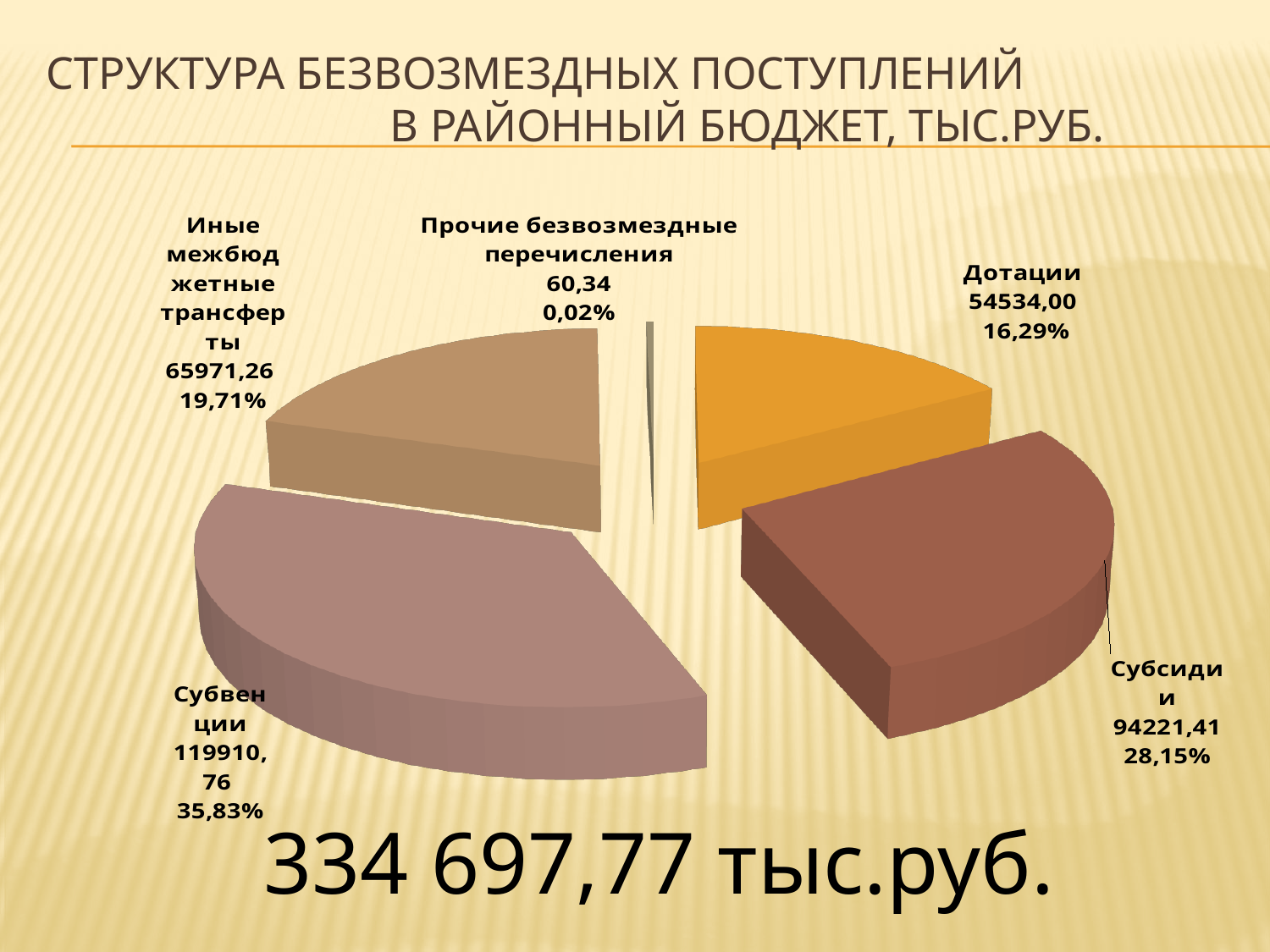
Which is larger, Дотации or Иные межбюджетные трансферты? Иные межбюджетные трансферты What share of the pie does Прочие безвозмездные перечисления represent? 0,02% What is the value for Субвенции? 119910,76 What is the difference between the values for Субвенции and Субсидии? 25689,35 What share of the pie does Субсидии represent? 28,15% What is the value for Иные межбюджетные трансферты? 65971,26 Which category has the smallest slice? Прочие безвозмездные перечисления How many slices does the pie chart have? 5 What kind of chart is shown on the slide? pie chart What is the value for Субсидии? 94221,41 Which category has the largest slice? Субвенции What is the value for Дотации? 54534,00